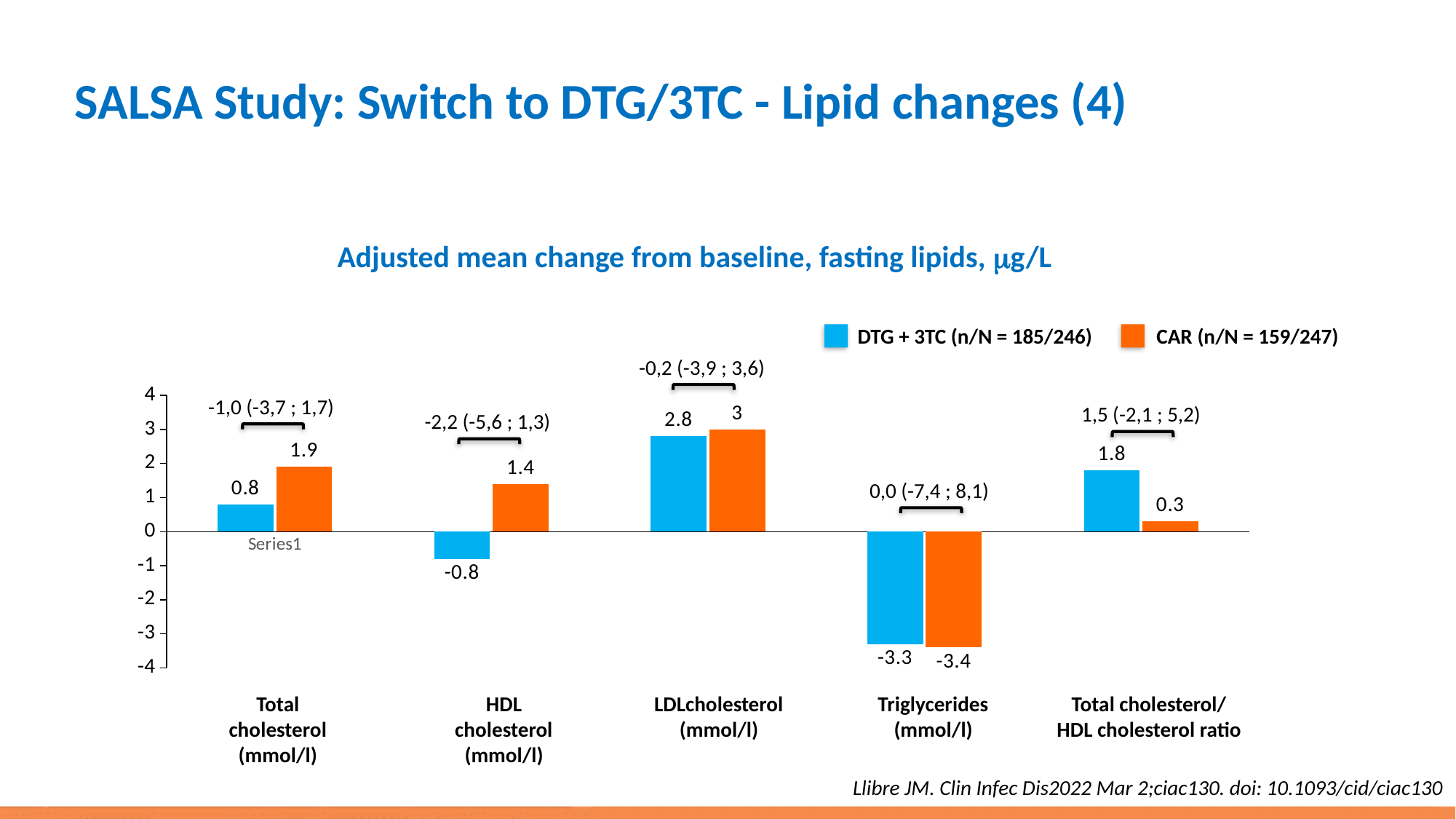
What is the value for DTG + 3TC for Triglycerides (mmol/l)? -3.3 How many lipid categories are shown on the x axis? 5 Which is larger for Total cholesterol/HDL cholesterol ratio: DTG + 3TC or CAR? DTG + 3TC What is the value for CAR for HDL cholesterol (mmol/l)? 1.4 What colour represents the CAR series in the chart? Orange What is the difference between the CAR and DTG + 3TC values for Total cholesterol (mmol/l)? 1.1 What is the value for CAR for Total cholesterol/HDL cholesterol ratio? 0.3 What kind of chart is shown on the slide? Bar chart What is the value for DTG + 3TC for Total cholesterol (mmol/l)? 0.8 Which category has the lowest value for the DTG + 3TC series? Triglycerides (mmol/l) How many series does the legend list? 2 Which category has the highest value for the CAR series? LDLcholesterol (mmol/l)